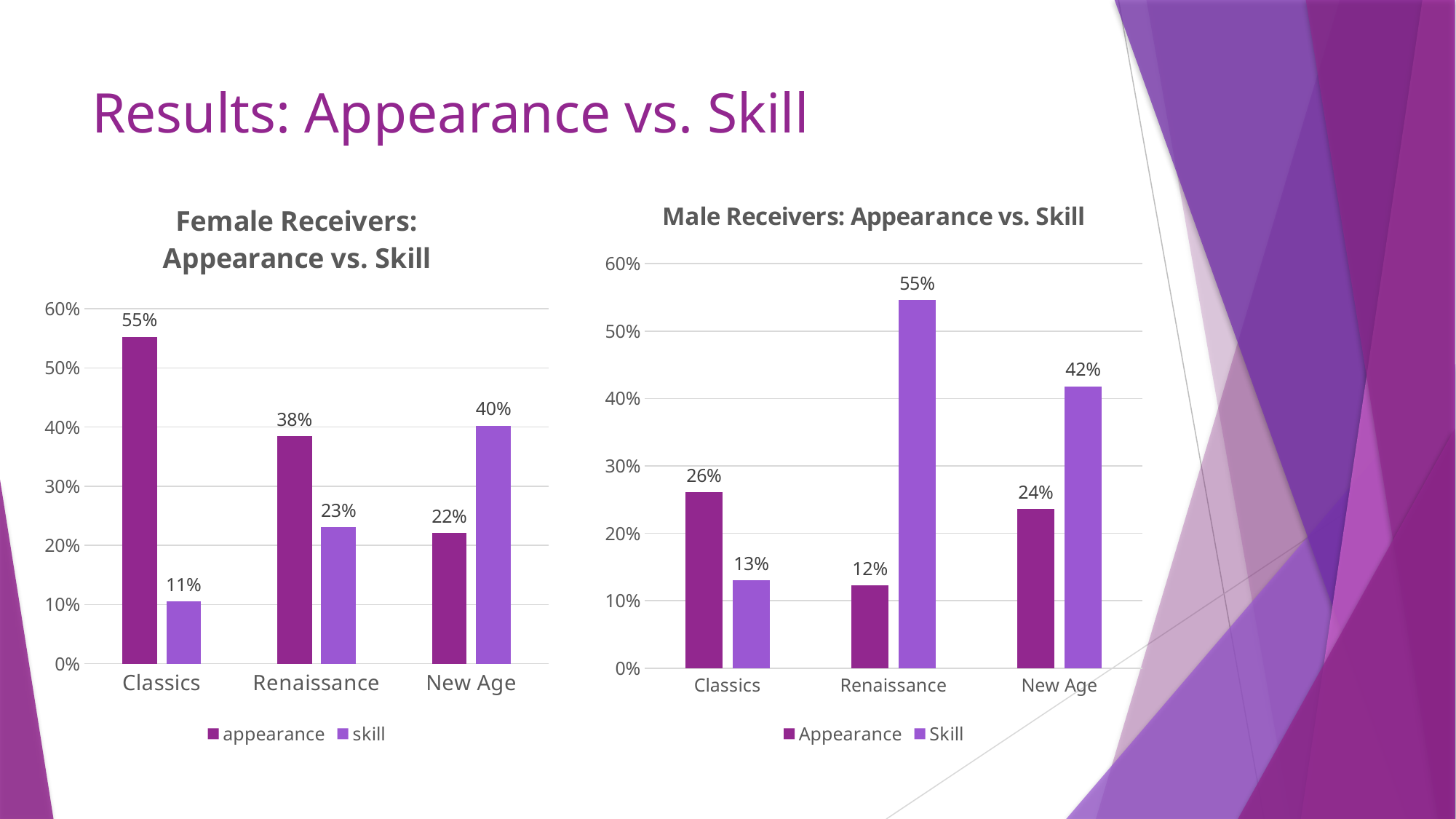
In the Female Receivers chart, what is the appearance value for Classics? 55% In the Male Receivers chart, which is larger for New Age: appearance or skill? skill How many series does the legend of the Male Receivers chart list? 2 In the Female Receivers chart, which category has the lowest skill value? Classics How many categories are shown on the x axis of the Female Receivers chart? 3 In the Male Receivers chart, what is the skill value for Renaissance? 55% What kind of chart is the Male Receivers chart? bar chart In the Male Receivers chart, what is the difference between the skill and appearance values for Classics? -13% In the Female Receivers chart, what is the skill value for New Age? 40% In the Male Receivers chart, what is the appearance value for New Age? 24% In the Female Receivers chart, what is the difference between the appearance and skill values for Renaissance? 15% In the Male Receivers chart, which category has the highest appearance value? Classics